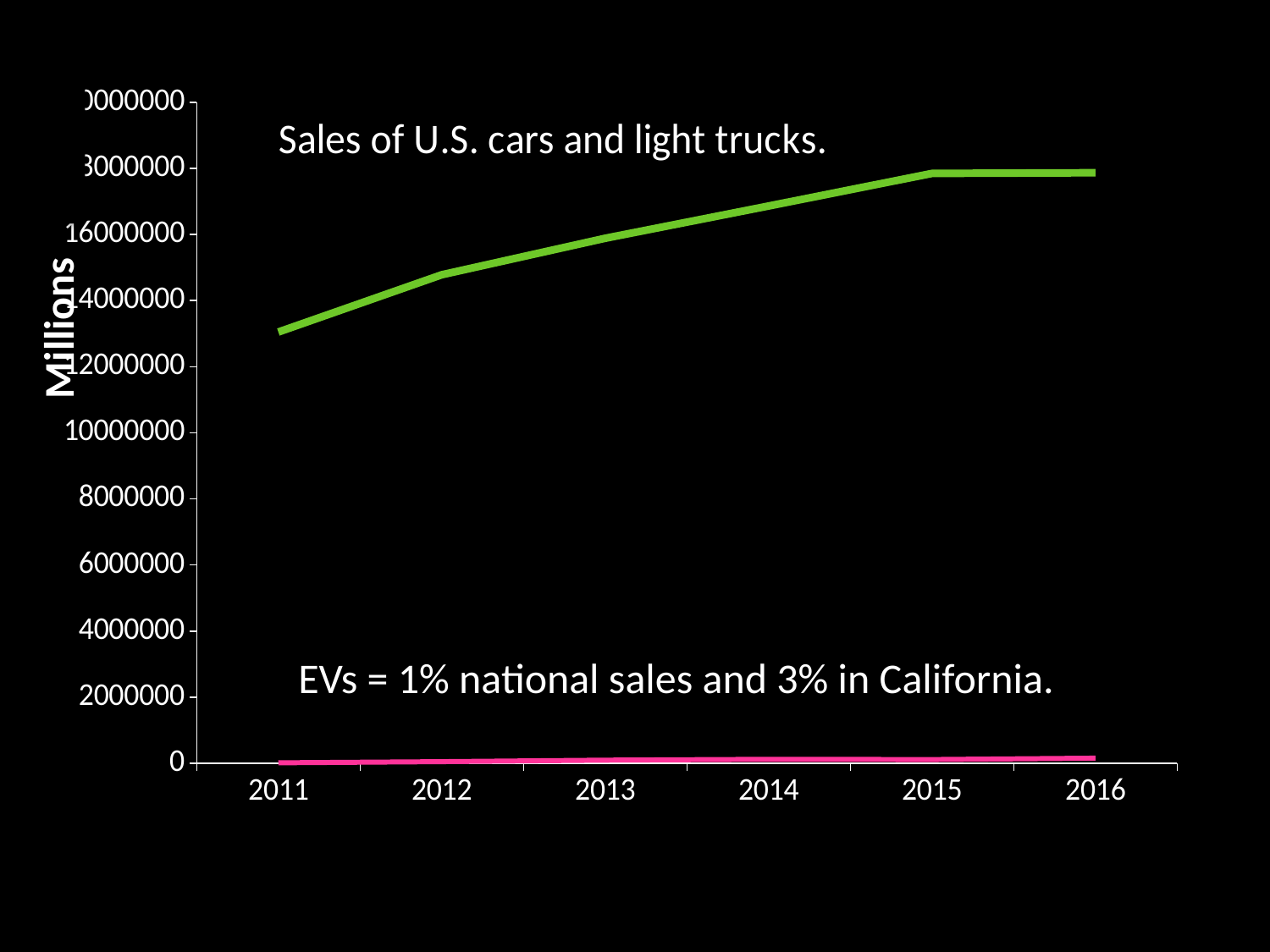
In which year is the green line for sales of U.S. cars and light trucks lowest? 2011 What is the label on the vertical axis? Millions Is the value of the green line (sales of U.S. cars and light trucks) in 2011 greater or less than 12000000? greater Is the value of the green line (sales of U.S. cars and light trucks) in 2011 greater or less than 14000000? less What kind of chart is shown on the slide? line chart Is the value of the green line (sales of U.S. cars and light trucks) in 2016 greater or less than 16000000? greater How many years are shown along the x axis? 6 Which year is the first on the x axis? 2011 Which is larger on the green line: the value for 2011 or the value for 2014? 2014 Does the green line for sales of U.S. cars and light trucks rise or fall from 2011 to 2015? rise